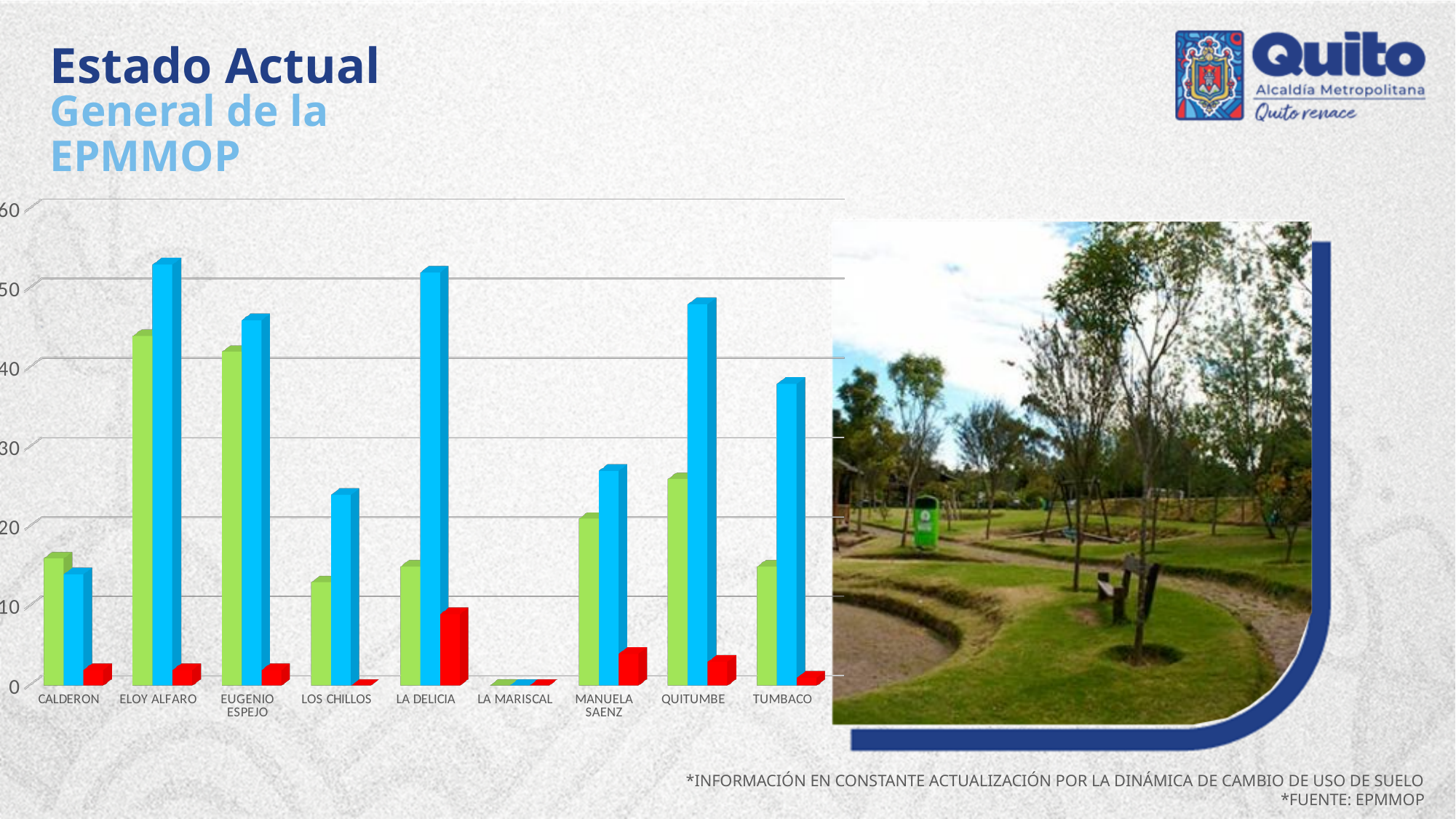
Which category has the highest red bar in the chart? LA DELICIA Which is larger, the blue bar for QUITUMBE or the blue bar for TUMBACO? QUITUMBE For LA DELICIA, which bar is taller, the green one or the blue one? the blue one Is the blue bar for TUMBACO greater or less than 40? less What colours are the three bars shown for each category? green, blue and red What kind of chart is shown on the slide? bar chart Is the blue bar for ELOY ALFARO greater or less than 50? greater Which category has the lowest bars overall in the chart? LA MARISCAL How many categories are shown on the x axis of the chart? 9 How many bars are plotted for each category in the chart? 3 Is the green bar for QUITUMBE greater or less than 20? greater